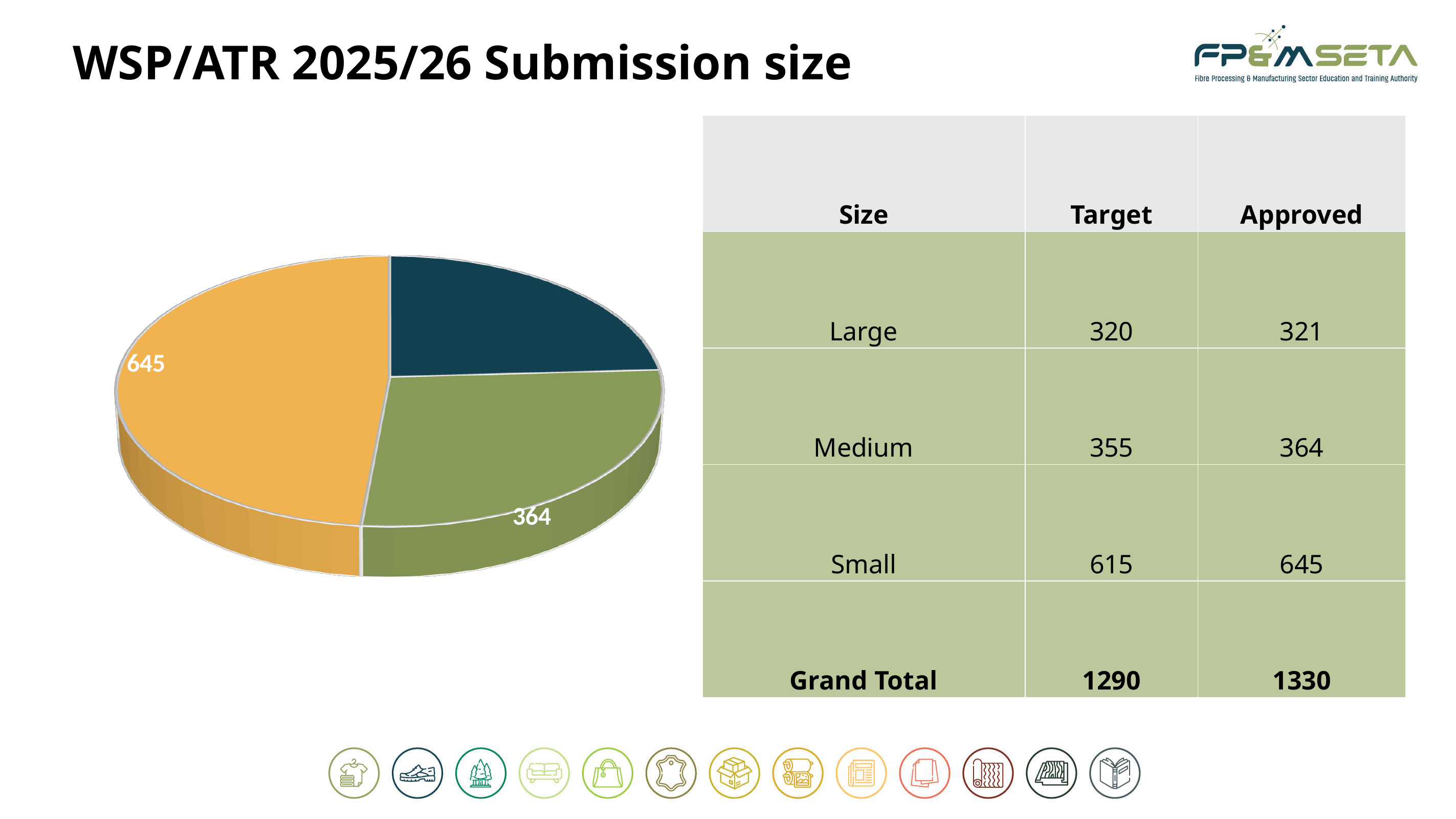
How many slices does the pie chart have? 3 What value is printed on the green slice of the pie chart? 364 Which is larger in the pie chart, the orange slice or the green slice? the orange slice Which slice of the pie chart is the largest? the orange slice (645) What is the difference between the values labelled on the orange slice and the green slice of the pie chart? 281 What kind of chart is shown on the slide? pie chart What colour is the slice of the pie chart that has no data label? dark blue What value is printed on the orange slice of the pie chart? 645 What is the largest value labelled on the pie chart? 645 How many slices of the pie chart have a data label printed on them? 2 Does the pie chart have a legend? No